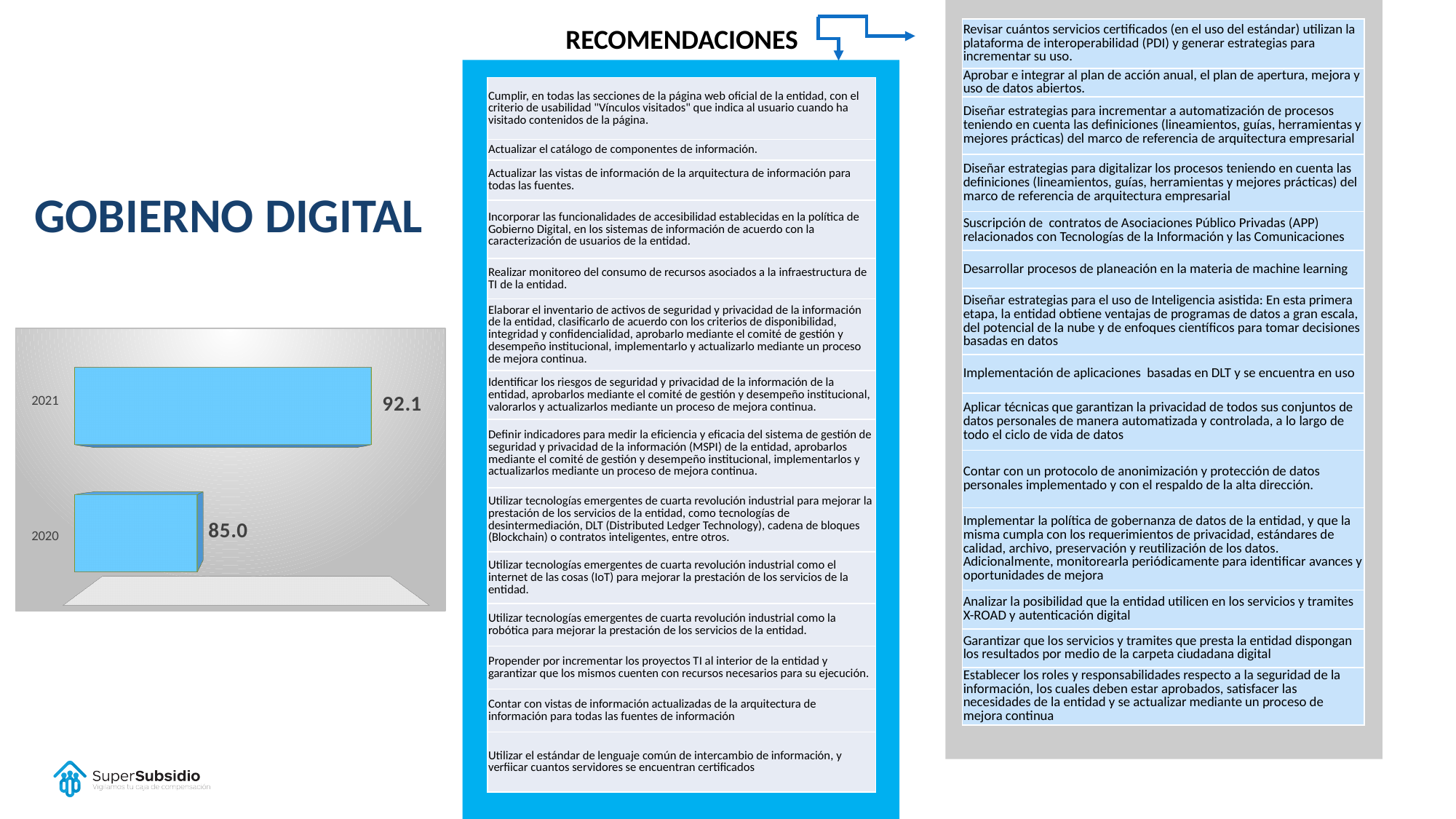
Did the value increase or decrease from 2020 to 2021? increase What is the difference between the 2021 and 2020 values in the chart? 7.1 What kind of chart is shown on the slide? bar chart What is the value for 2021 in the chart? 92.1 Which year has the higher value in the chart? 2021 How many bars are shown in the chart? 2 What colour are the bars in the chart? blue Is the value for 2020 larger or smaller than the value for 2021? smaller Are the bars in the chart horizontal or vertical? horizontal What is the value for 2020 in the chart? 85.0 Which year has the lower value in the chart? 2020